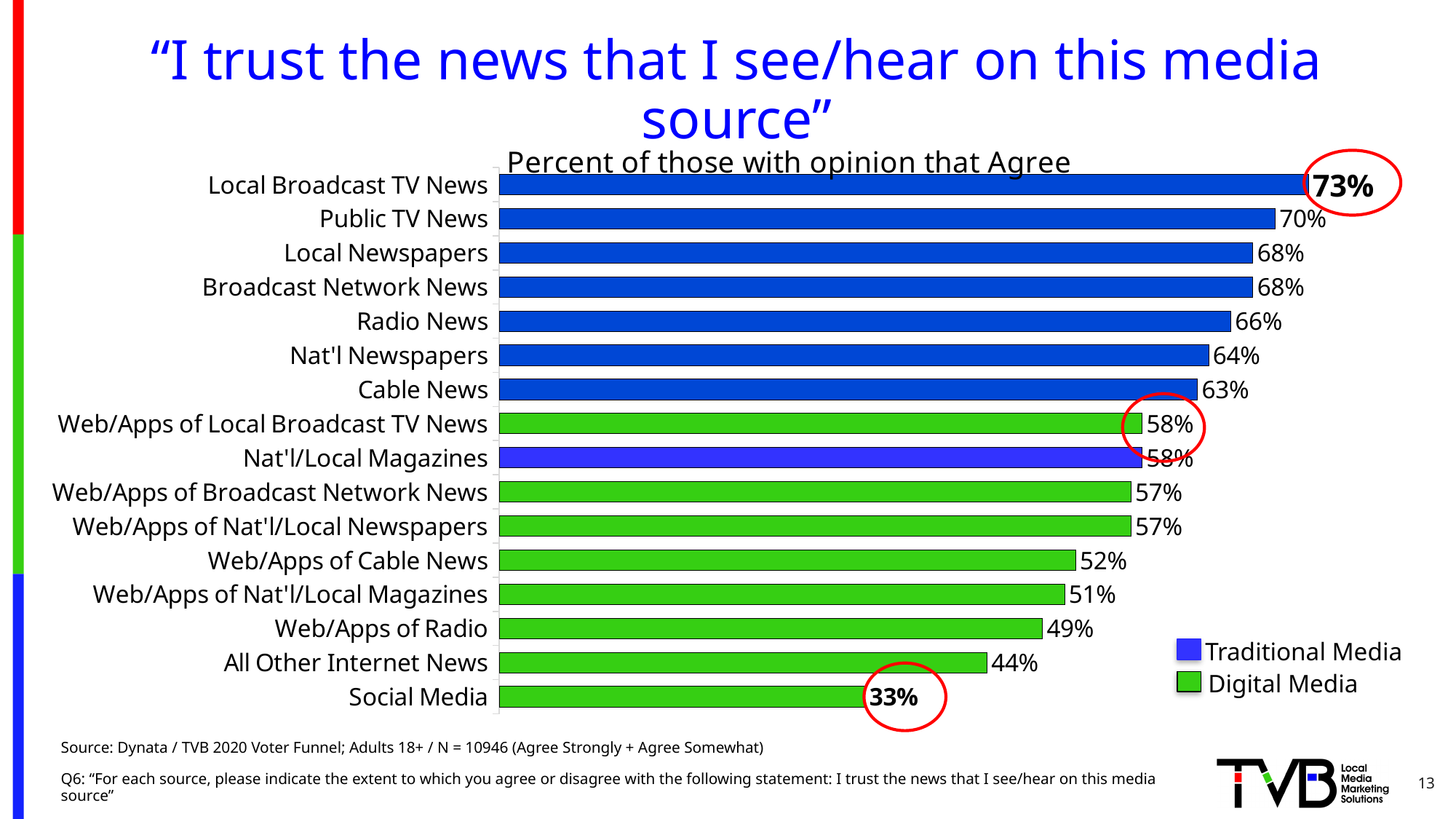
How many media sources are shown in the chart? 16 What is the value for Web/Apps of Local Broadcast TV News? 58% How many entries does the legend list? 2 What is the value for Local Broadcast TV News? 73% What is the difference between the values for Local Broadcast TV News and Social Media? 40% What is the value for Social Media? 33% What is the value for Cable News? 63% Which media source has the lowest percentage of agreement? Social Media Which media source has the highest percentage of agreement? Local Broadcast TV News Which is larger, the value for Radio News or the value for Web/Apps of Cable News? Radio News What is the difference between the values for Public TV News and Web/Apps of Radio? 21% What kind of chart is shown on the slide? Bar chart